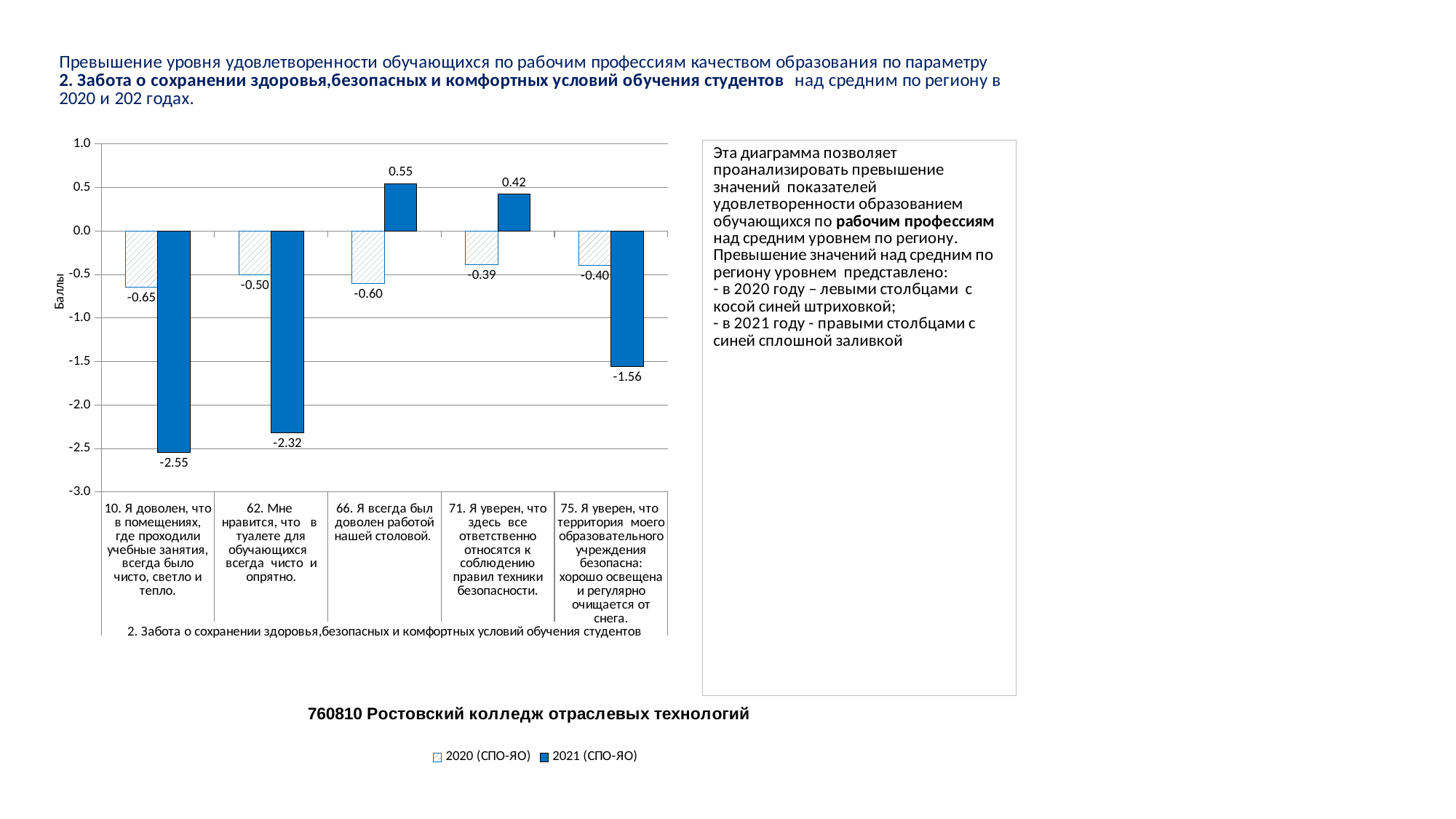
Which category has the lowest 2021 (СПО-ЯО) value? 10. Я доволен, что в помещениях, где проходили учебные занятия, всегда было чисто, светло и тепло. What is the 2020 (СПО-ЯО) value for category 66 ("Я всегда был доволен работой нашей столовой")? -0.60 What is the difference between the 2021 (СПО-ЯО) values for category 66 and category 71? 0.13 What is the 2021 (СПО-ЯО) value for category 75 ("Я уверен, что территория моего образовательного учреждения безопасна")? -1.56 Which category has the highest 2021 (СПО-ЯО) value? 66. Я всегда был доволен работой нашей столовой. Which category has the lowest 2020 (СПО-ЯО) value? 10. Я доволен, что в помещениях, где проходили учебные занятия, всегда было чисто, светло и тепло. For category 62 ("Мне нравится, что в туалете для обучающихся всегда чисто и опрятно"), which series has the larger value, 2020 (СПО-ЯО) or 2021 (СПО-ЯО)? 2020 (СПО-ЯО) What is the 2021 (СПО-ЯО) value for category 10 ("Я доволен, что в помещениях, где проходили учебные занятия, всегда было чисто, светло и тепло")? -2.55 What is the 2020 (СПО-ЯО) value for category 71 ("Я уверен, что здесь все ответственно относятся к соблюдению правил техники безопасности")? -0.39 How many categories are shown on the x axis of the chart? 5 What type of chart is shown on the slide? Bar chart How many series does the chart legend list? 2